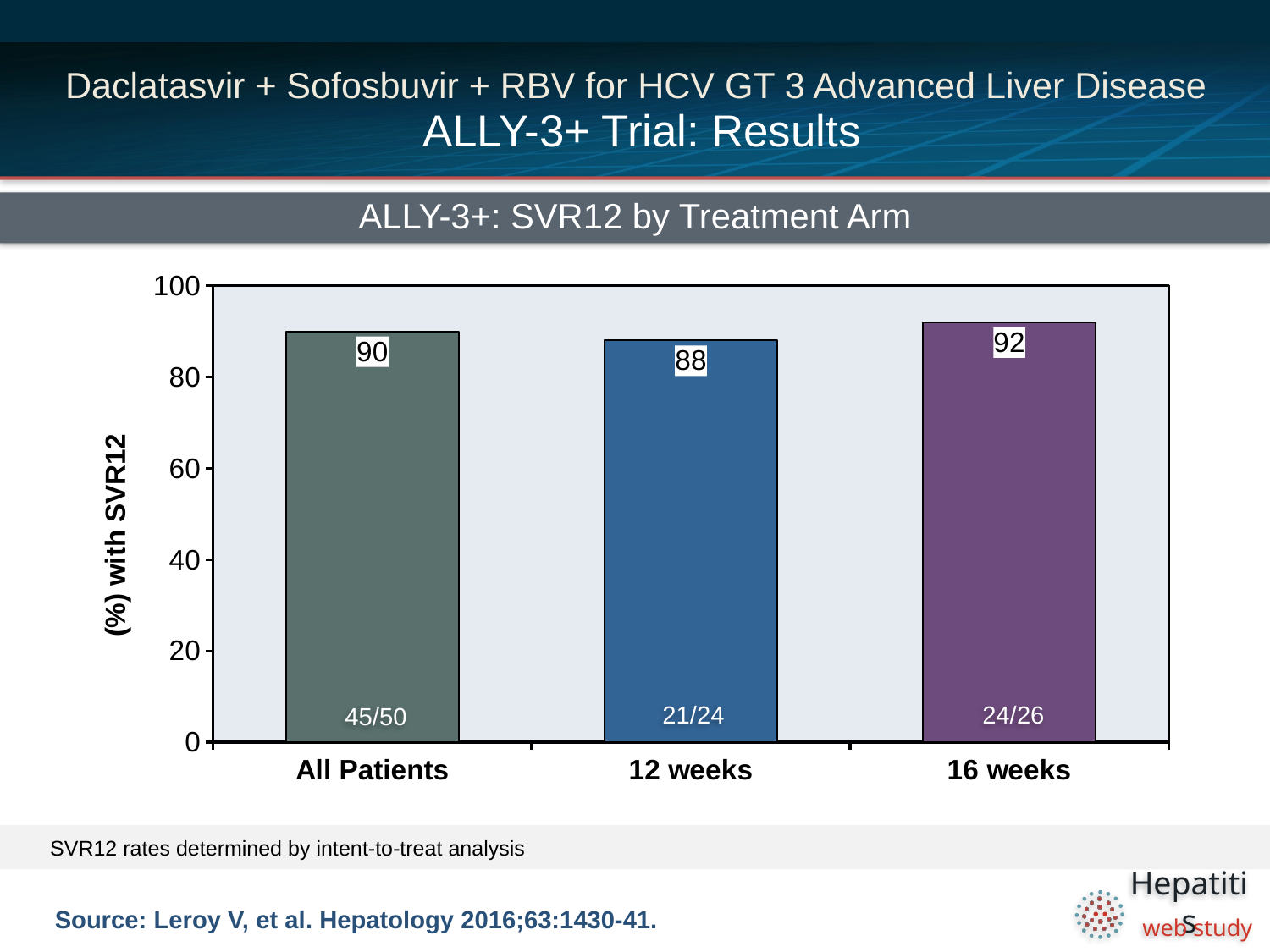
Is the SVR12 rate for All Patients greater or less than 80? greater How many categories are shown on the x axis? 3 What fraction of patients is shown inside the 12 weeks bar? 21/24 What kind of chart is shown on the slide? Bar chart What is the title of the chart? ALLY-3+: SVR12 by Treatment Arm What is the SVR12 rate for the 12 weeks arm? 88 What is the SVR12 rate for All Patients? 90 What fraction of patients is shown inside the 16 weeks bar? 24/26 What is the difference in SVR12 rate between the 16 weeks and 12 weeks arms? 4 Which category has the lowest SVR12 rate? 12 weeks What is the SVR12 rate for the 16 weeks arm? 92 Which treatment arm has the highest SVR12 rate? 16 weeks